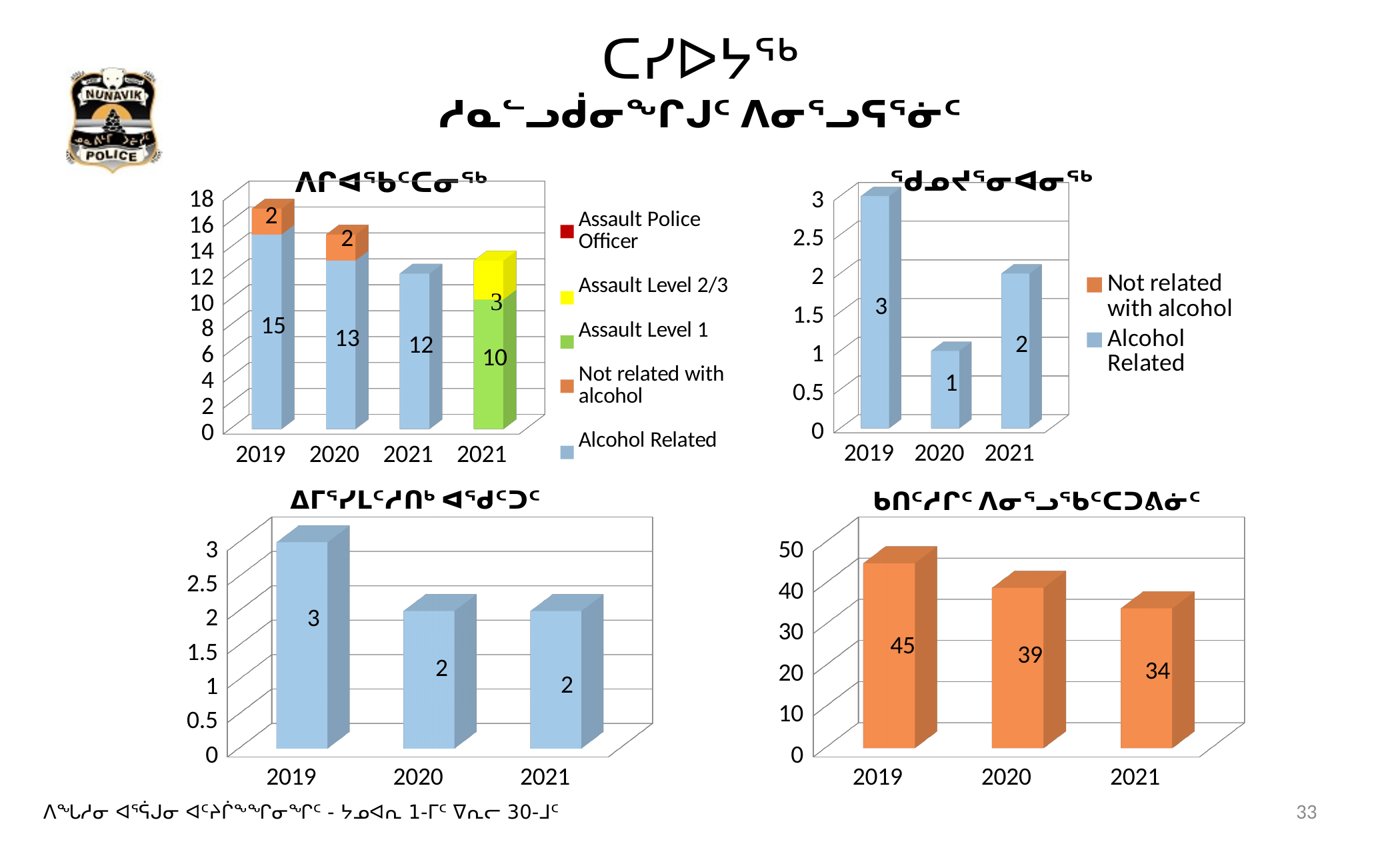
In the bottom-right chart, what is the difference between the 2019 and 2021 values? 11 In the bottom-right chart, what is the value for 2020? 39 In the bottom-left chart, what is the difference between the 2019 and 2020 values? 1 In the top-left chart, what is the Alcohol Related value for 2019? 15 In the top-right chart, which year has the lowest value? 2020 In the top-left chart, what is the Not related with alcohol value for 2020? 2 How many series does the legend of the top-left chart list? 5 In the top-left chart, what is the total of the stacked bar for 2019? 17 In the top-right chart, what is the value for 2021? 2 In the bottom-left chart, how many years are shown on the x axis? 3 In the bottom-right chart, do the values rise or fall from 2019 to 2021? fall In the top-left chart, what is the Assault Level 1 value shown in the green segment? 10